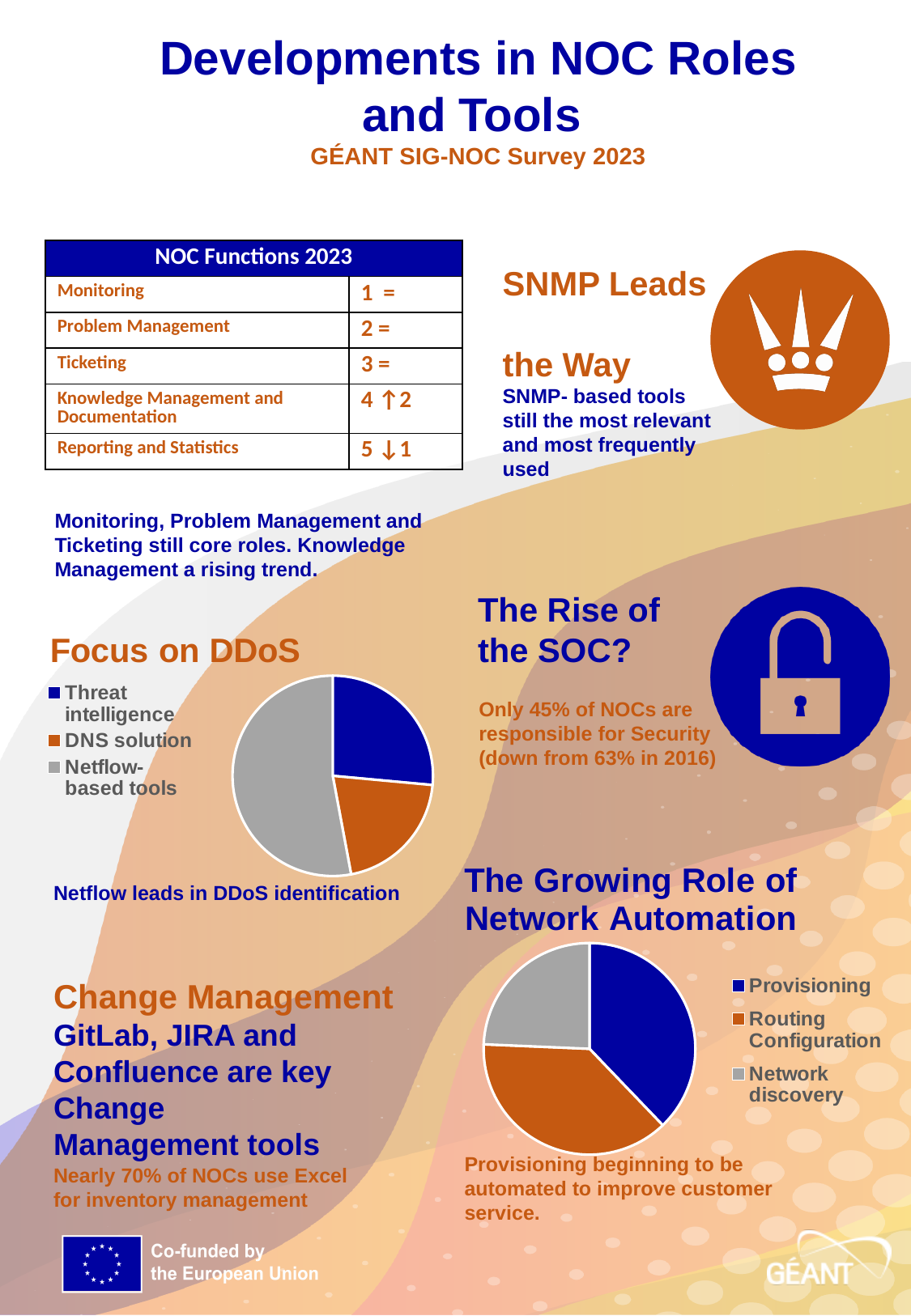
In the 'Focus on DDoS' chart, which category has the smallest slice? DNS solution What kind of chart is the 'The Growing Role of Network Automation' chart? pie chart In the 'The Growing Role of Network Automation' chart, how many categories does the legend list? 3 In the 'The Growing Role of Network Automation' chart, which category has the smallest slice? Network discovery What kind of chart is the 'Focus on DDoS' chart? pie chart In the 'Focus on DDoS' chart, which slice is larger: Threat intelligence or DNS solution? Threat intelligence In the 'Focus on DDoS' chart, what colour is the Netflow-based tools slice? grey In the 'The Growing Role of Network Automation' chart, which slice is larger: Provisioning or Network discovery? Provisioning In the 'The Growing Role of Network Automation' chart, which slice is larger: Routing Configuration or Network discovery? Routing Configuration In the 'Focus on DDoS' chart, how many slices does the pie have? 3 In the 'Focus on DDoS' chart, which category has the largest slice? Netflow-based tools In the 'The Growing Role of Network Automation' chart, which category is shown in orange? Routing Configuration